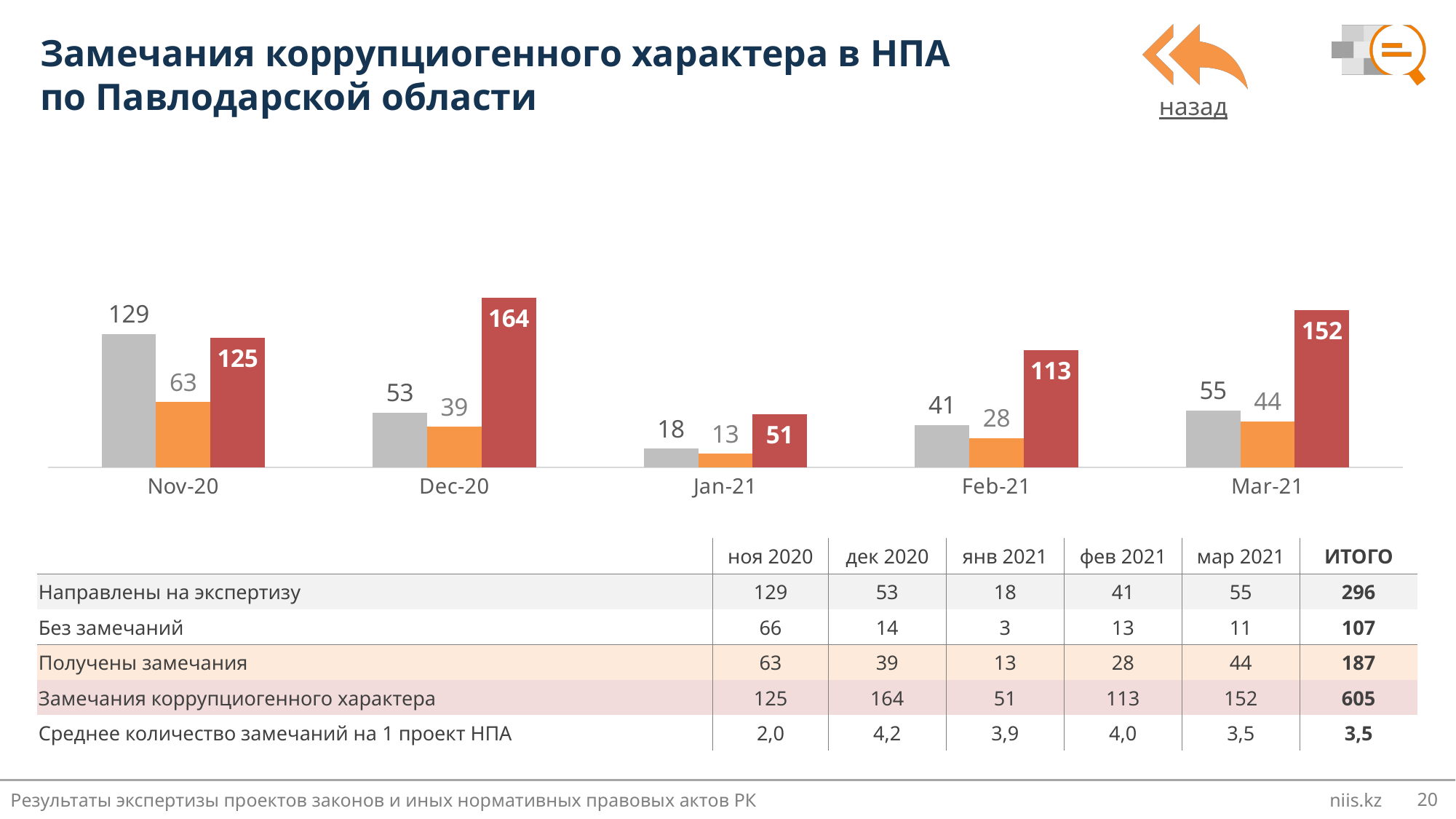
What is the difference between the red bar values for Mar-21 and Feb-21? 39 What type of chart is shown on the slide? bar chart In which month is the gray bar the lowest? Jan-21 In which month is the red bar the highest? Dec-20 Which is larger for Nov-20: the gray bar or the red bar? the gray bar What is the value of the gray bar for Nov-20? 129 What is the value of the orange bar for Mar-21? 44 How many months are shown on the x axis of the chart? 5 What is the title of the slide containing the chart? Замечания коррупциогенного характера в НПА по Павлодарской области What is the value of the red bar for Dec-20? 164 Does the orange bar rise or fall from Nov-20 to Jan-21? fall What is the difference between the gray and orange bar values for Dec-20? 14